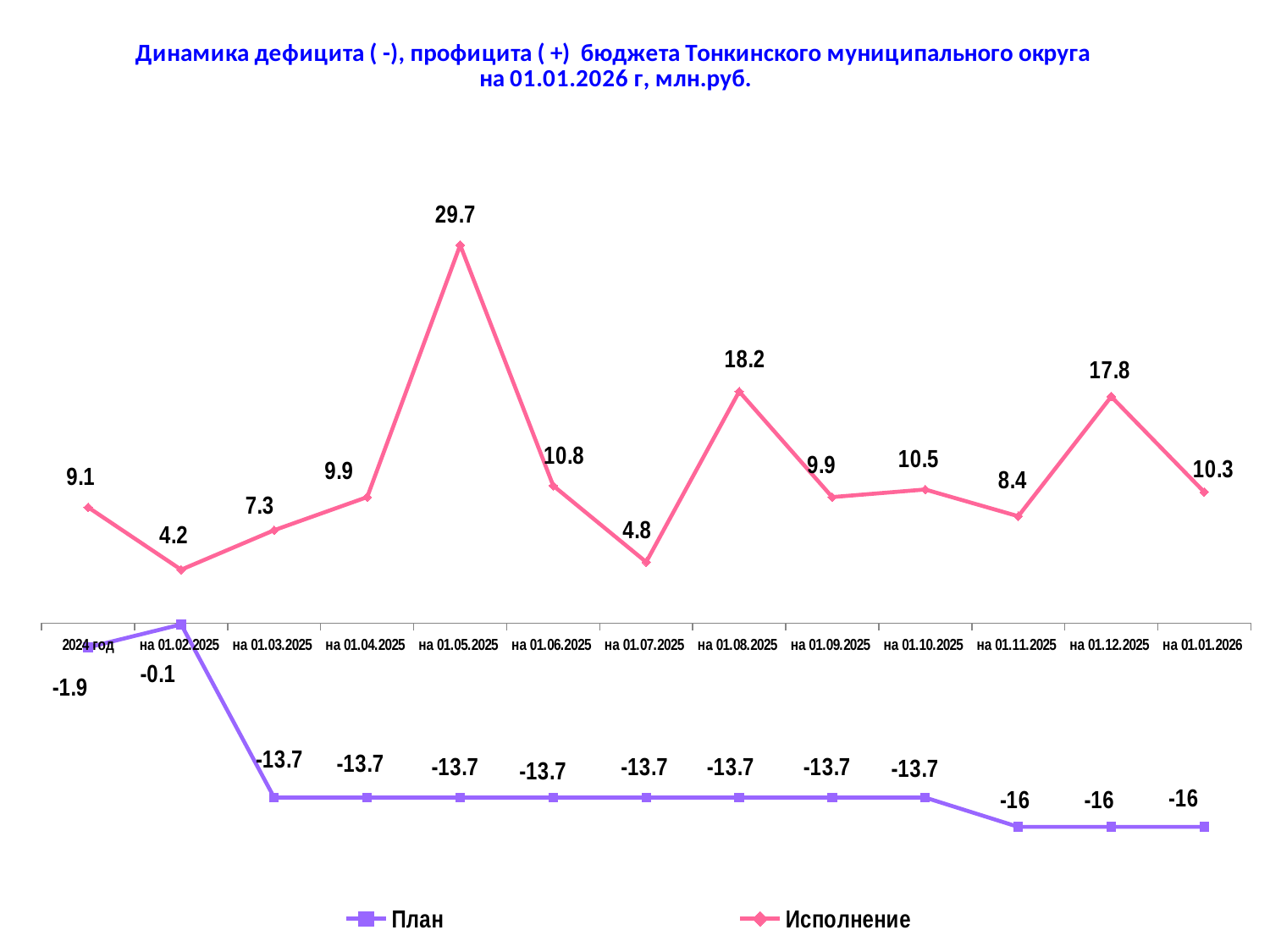
What type of chart is shown on the slide? line chart What is the value of План for 2024 год? -1.9 At which date is Исполнение at its lowest value? на 01.02.2025 What is the value of Исполнение на 01.12.2025? 17.8 How many series does the legend list? 2 What is the difference between Исполнение на 01.08.2025 and Исполнение на 01.07.2025? 13.4 What is the value of Исполнение на 01.05.2025? 29.7 At which date does Исполнение reach its highest value? на 01.05.2025 What is the value of План на 01.01.2026? -16 Which series is drawn in pink? Исполнение How many points are plotted along the x axis for each series? 13 Which is larger: Исполнение на 01.06.2025 or Исполнение на 01.10.2025? Исполнение на 01.06.2025